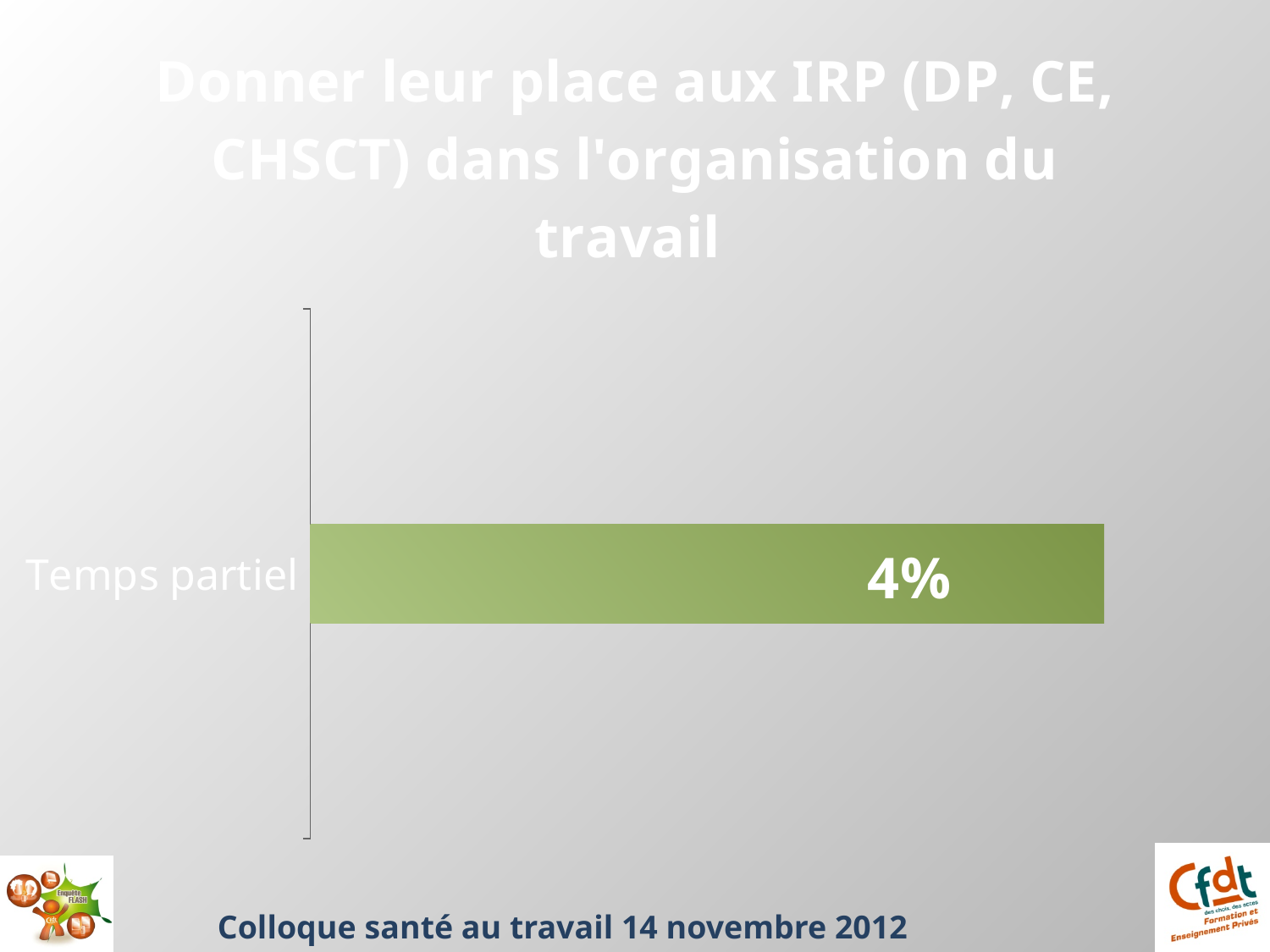
What is the value shown for Temps partiel? 4% What is the label of the single category on the chart? Temps partiel What is the title of the chart? Donner leur place aux IRP (DP, CE, CHSCT) dans l'organisation du travail Is the value for Temps partiel greater or less than 10%? less What kind of chart is shown on the slide? bar chart How many categories does the chart show? 1